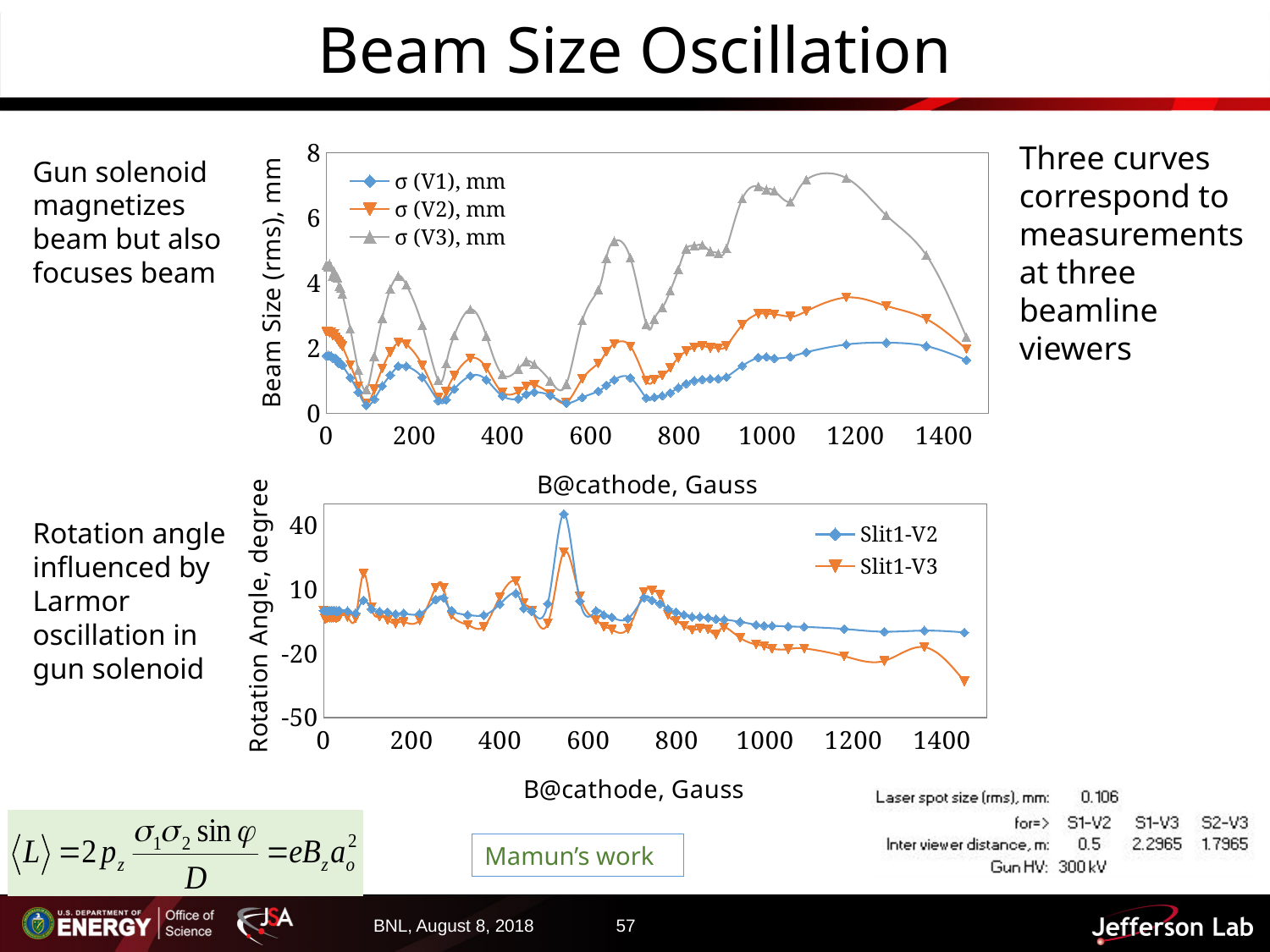
In the top chart (Beam Size vs B@cathode), which series reaches the highest beam size? σ (V3), mm In the bottom chart (Rotation Angle vs B@cathode), is the value of Slit1-V3 at about 1450 Gauss greater or less than -20? less In the top chart (Beam Size vs B@cathode), how many series does the legend list? 3 What is the x-axis title of the bottom chart? B@cathode, Gauss In the bottom chart (Rotation Angle vs B@cathode), how many series does the legend list? 2 In the top chart (Beam Size vs B@cathode), is the highest value of σ (V1) greater or less than 4? less In the bottom chart (Rotation Angle vs B@cathode), at about 550 Gauss, which series has the larger rotation angle, Slit1-V2 or Slit1-V3? Slit1-V2 In the bottom chart (Rotation Angle vs B@cathode), does the Slit1-V3 series rise or fall between 800 and 1400 Gauss? fall In the top chart (Beam Size vs B@cathode), is the peak value of σ (V3) near 1150 Gauss greater or less than 6? greater What is the y-axis title of the top chart? Beam Size (rms), mm In the top chart (Beam Size vs B@cathode), which series stays lowest across the range? σ (V1), mm What kind of chart is the top chart (Beam Size vs B@cathode)? Line chart